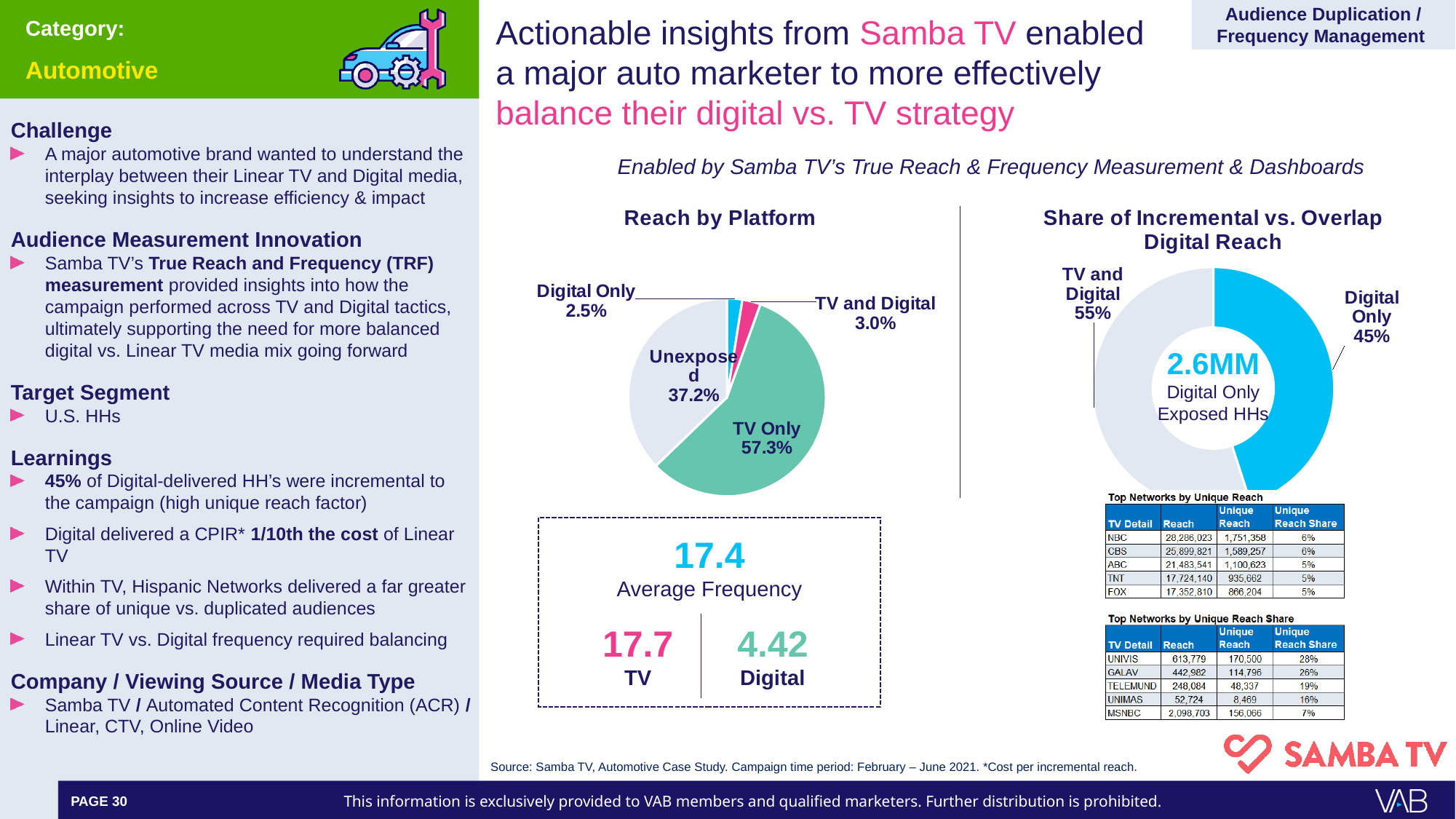
In the 'Share of Incremental vs. Overlap Digital Reach' chart, what share is TV and Digital? 55% In the 'Reach by Platform' chart, what share is TV Only? 57.3% In the 'Share of Incremental vs. Overlap Digital Reach' chart, what share is Digital Only? 45% In the 'Reach by Platform' chart, which category has the largest share? TV Only What type of chart is 'Reach by Platform'? Pie chart In the 'Reach by Platform' chart, which category has the smallest share? Digital Only In the 'Share of Incremental vs. Overlap Digital Reach' chart, which is larger, TV and Digital or Digital Only? TV and Digital In the 'Reach by Platform' chart, how many slices does the pie have? 4 In the 'Reach by Platform' chart, what is the difference between the TV Only and Unexposed shares? 20.1% In the 'Reach by Platform' chart, what share is Digital Only? 2.5% In the 'Reach by Platform' chart, what share is Unexposed? 37.2% What number is shown in the center of the 'Share of Incremental vs. Overlap Digital Reach' donut chart? 2.6MM